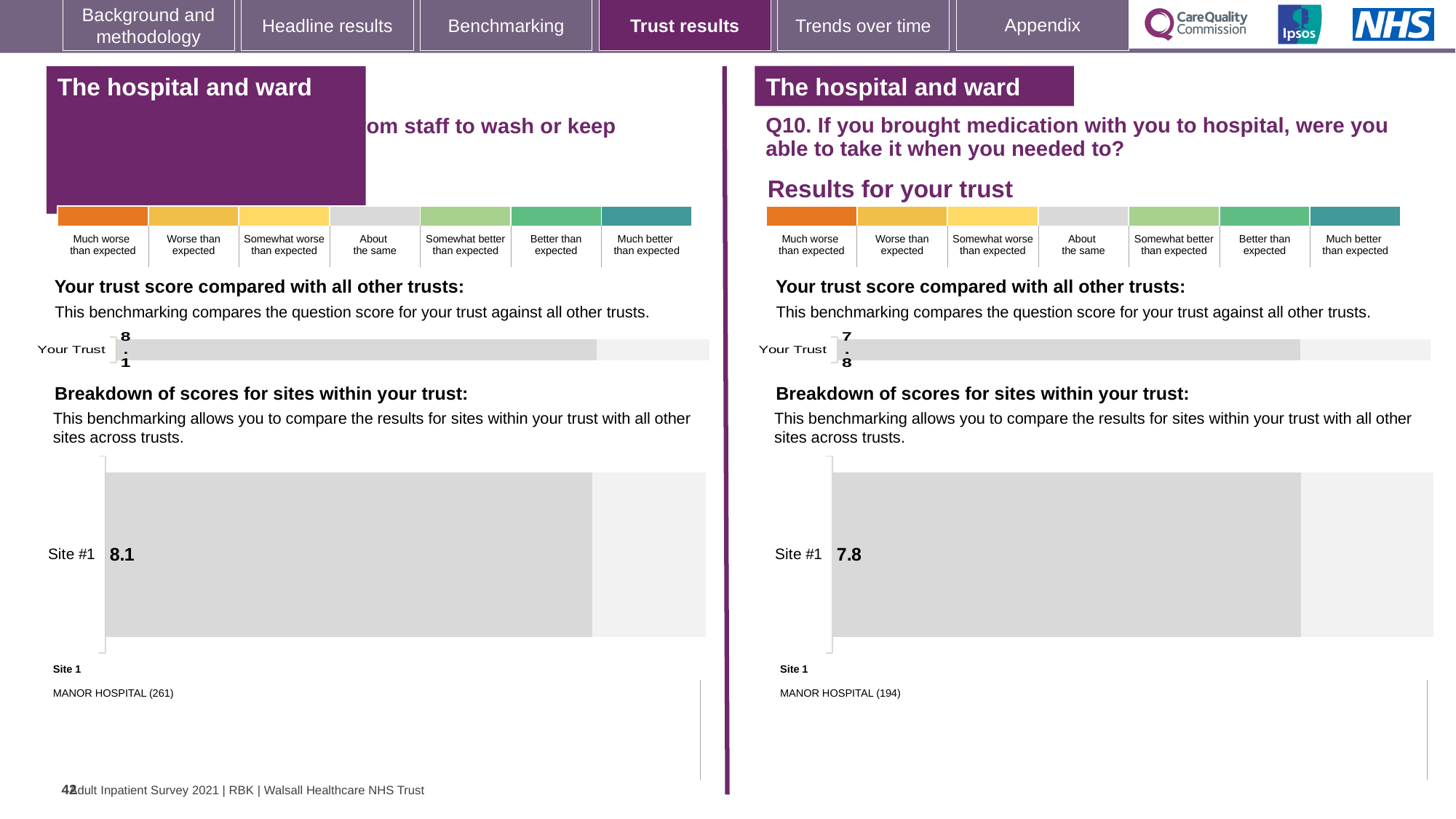
In the left-hand 'Breakdown of scores for sites within your trust' chart, what is the score for Site #1? 8.1 Which hospital is listed as Site 1 on the left-hand side of the slide? MANOR HOSPITAL (261) What kind of chart is used to show the Site #1 score on the right-hand side of the slide? Bar chart On the right-hand side of the slide (Q10), what is the score shown for Your Trust? 7.8 On the left-hand side of the slide, what is the score shown for Your Trust? 8.1 Which hospital is listed as Site 1 on the right-hand side of the slide (Q10)? MANOR HOSPITAL (194) Which is larger: the Your Trust score on the left-hand side of the slide or the Your Trust score on the right-hand side (Q10)? Left-hand side (8.1) How many sites are shown in the right-hand 'Breakdown of scores for sites within your trust' chart? 1 What is the difference between the Site #1 score on the left-hand side of the slide and the Site #1 score on the right-hand side (Q10)? 0.3 Is the Your Trust score on the right-hand side of the slide (Q10) greater or less than 8? less In the right-hand 'Breakdown of scores for sites within your trust' chart, what is the score for Site #1? 7.8 Is the Site #1 score on the left-hand side of the slide greater or less than 8? greater